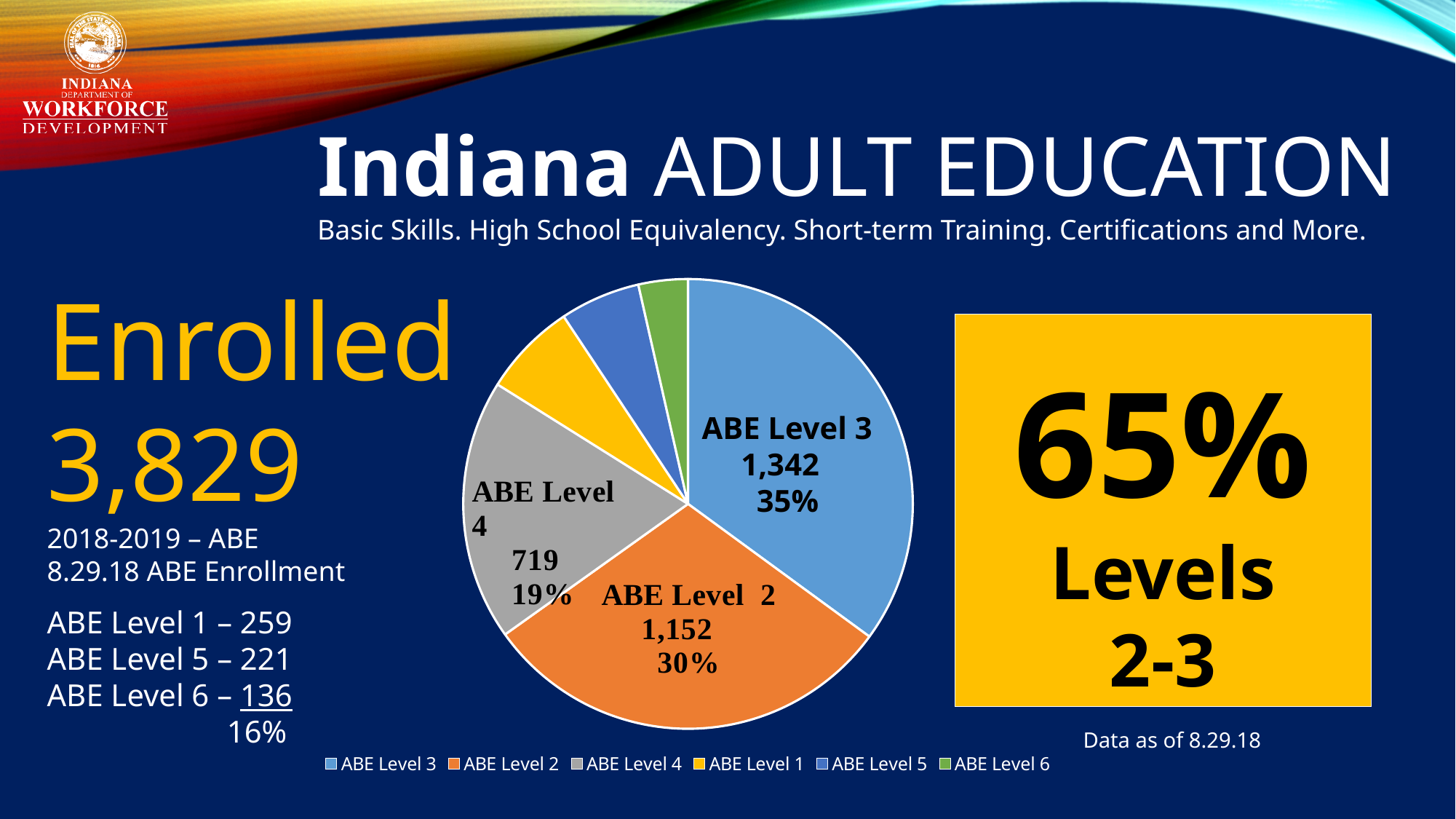
What is the enrollment value shown for ABE Level 2 in the pie chart? 1,152 What is the difference between the ABE Level 3 and ABE Level 2 values in the pie chart? 190 Which is larger in the pie chart, ABE Level 2 or ABE Level 4? ABE Level 2 How many entries does the pie chart's legend list? 6 What is the enrollment value shown for ABE Level 4 in the pie chart? 719 What share of the pie does ABE Level 4 represent? 19% Which ABE level has the smallest slice in the pie chart? ABE Level 6 What kind of chart is shown on the slide? pie chart How many slices does the pie chart have? 6 Which ABE level has the largest slice in the pie chart? ABE Level 3 What is the enrollment value shown for ABE Level 3 in the pie chart? 1,342 What colour is the ABE Level 1 slice in the pie chart? yellow